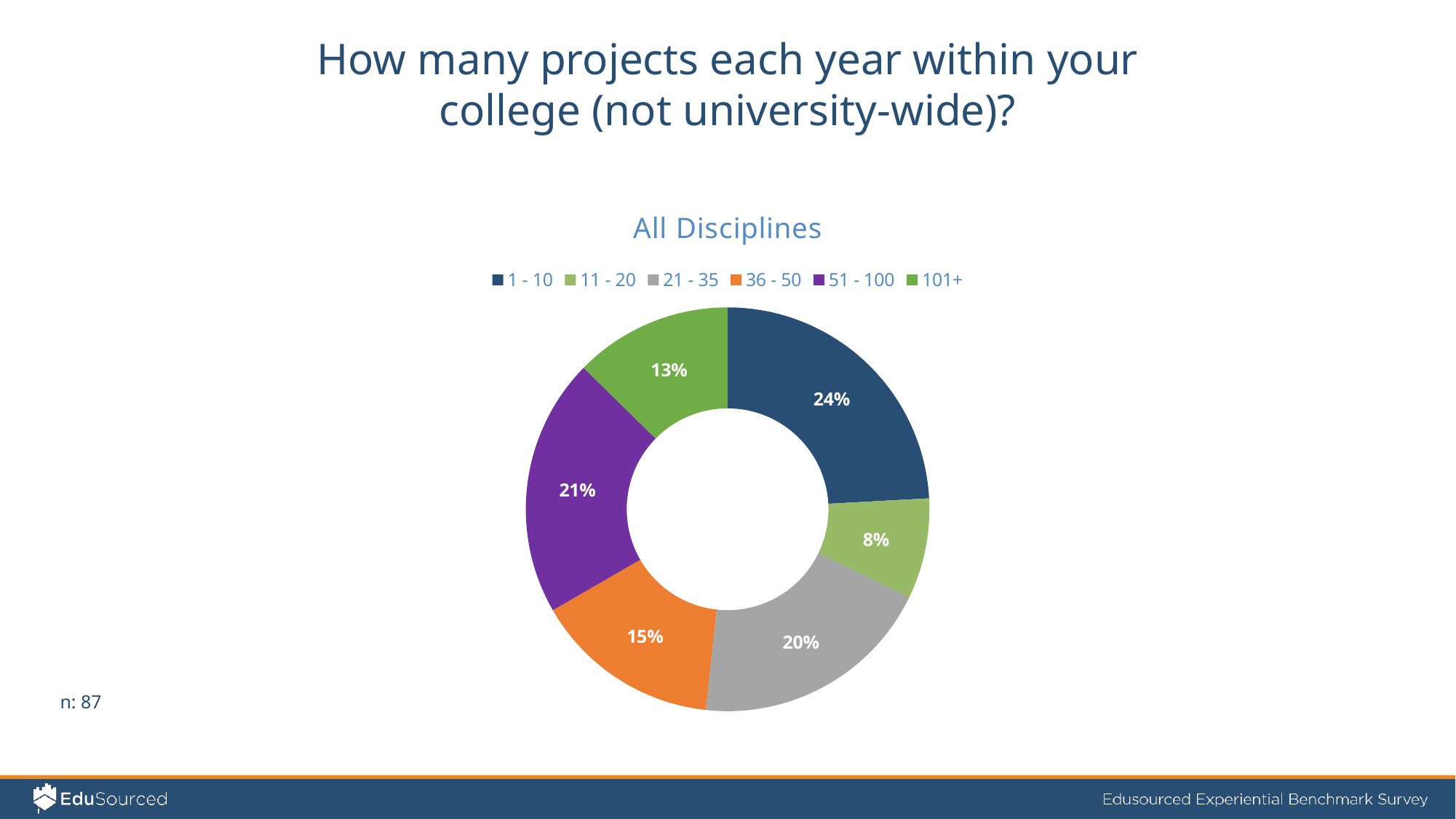
What is the difference in percentage points between the 21 - 35 and 11 - 20 categories? 12 What kind of chart is shown on the slide? Doughnut chart How many categories are shown in the chart? 6 Which category has a larger share, 36 - 50 or 101+? 36 - 50 Which category has the smallest share of the chart? 11 - 20 What percentage of respondents reported 101+ projects each year? 13% What colour represents the 51 - 100 category in the chart? Purple What is the title of the chart? All Disciplines What percentage of respondents reported 1 - 10 projects each year? 24% What percentage of respondents reported 51 - 100 projects each year? 21% Which category has the largest share of the chart? 1 - 10 What percentage of respondents reported 36 - 50 projects each year? 15%